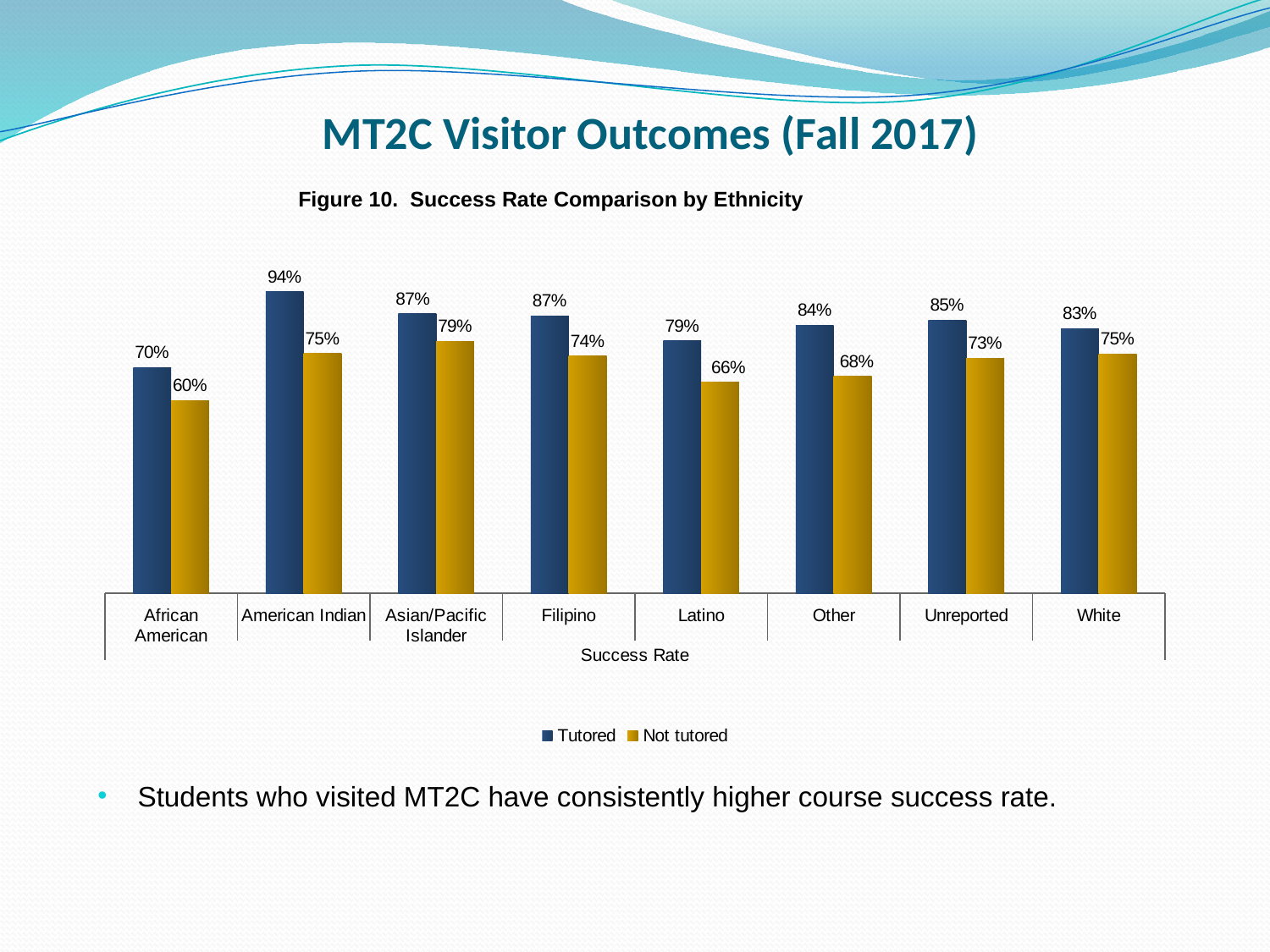
What is the Tutored success rate for American Indian students? 94% What kind of chart is shown on the slide? Bar chart What is the title of the figure shown on the slide? Figure 10. Success Rate Comparison by Ethnicity What is the Not tutored success rate for Latino students? 66% Which ethnicity has the lowest Not tutored success rate? African American What is the difference between the Tutored and Not tutored success rates for Filipino students? 13% Which is larger, the Tutored success rate for Other or the Tutored success rate for White? Other How many series does the legend list? 2 What is the Not tutored success rate for African American students? 60% Which ethnicity has the highest Tutored success rate? American Indian What is the difference between the Tutored and Not tutored success rates for Latino students? 13% How many ethnicity categories are shown on the x axis? 8